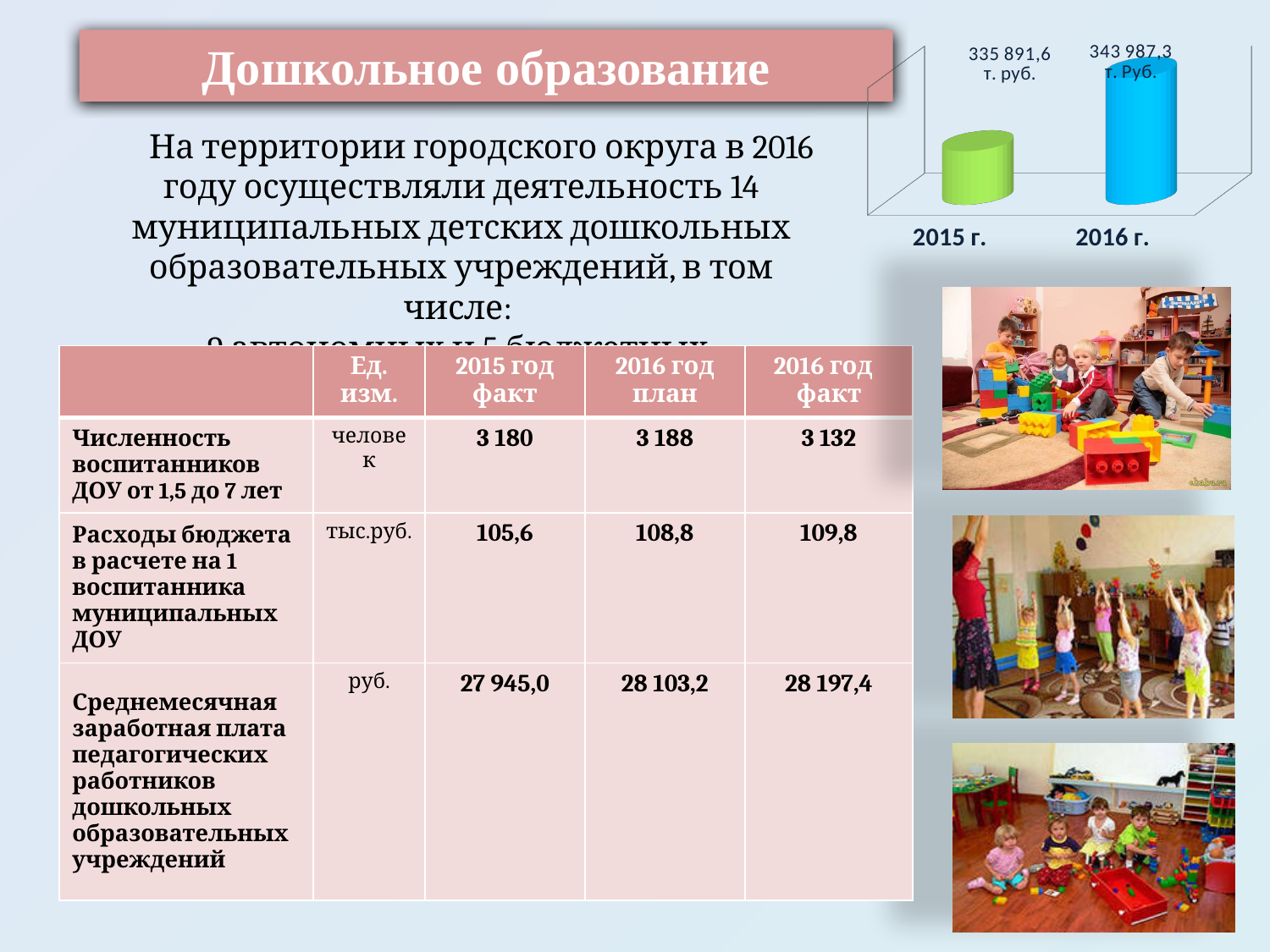
Which year has the higher value in the bar chart? 2016 г. By how much does the 2016 г. value exceed the 2015 г. value in the bar chart? 8 095,7 т. руб. What colour is the bar for 2015 г. in the chart? green What colour is the bar for 2016 г. in the chart? blue Which year has the lower value in the bar chart? 2015 г. What value is shown for 2016 г. in the bar chart? 343 987,3 т. руб. Is the value for 2016 г. larger or smaller than the value for 2015 г. in the bar chart? larger How many bars are plotted in the chart? 2 What kind of chart is shown in the top right of the slide? bar chart What value is shown for 2015 г. in the bar chart? 335 891,6 т. руб. Do the values in the bar chart rise or fall from 2015 г. to 2016 г.? rise